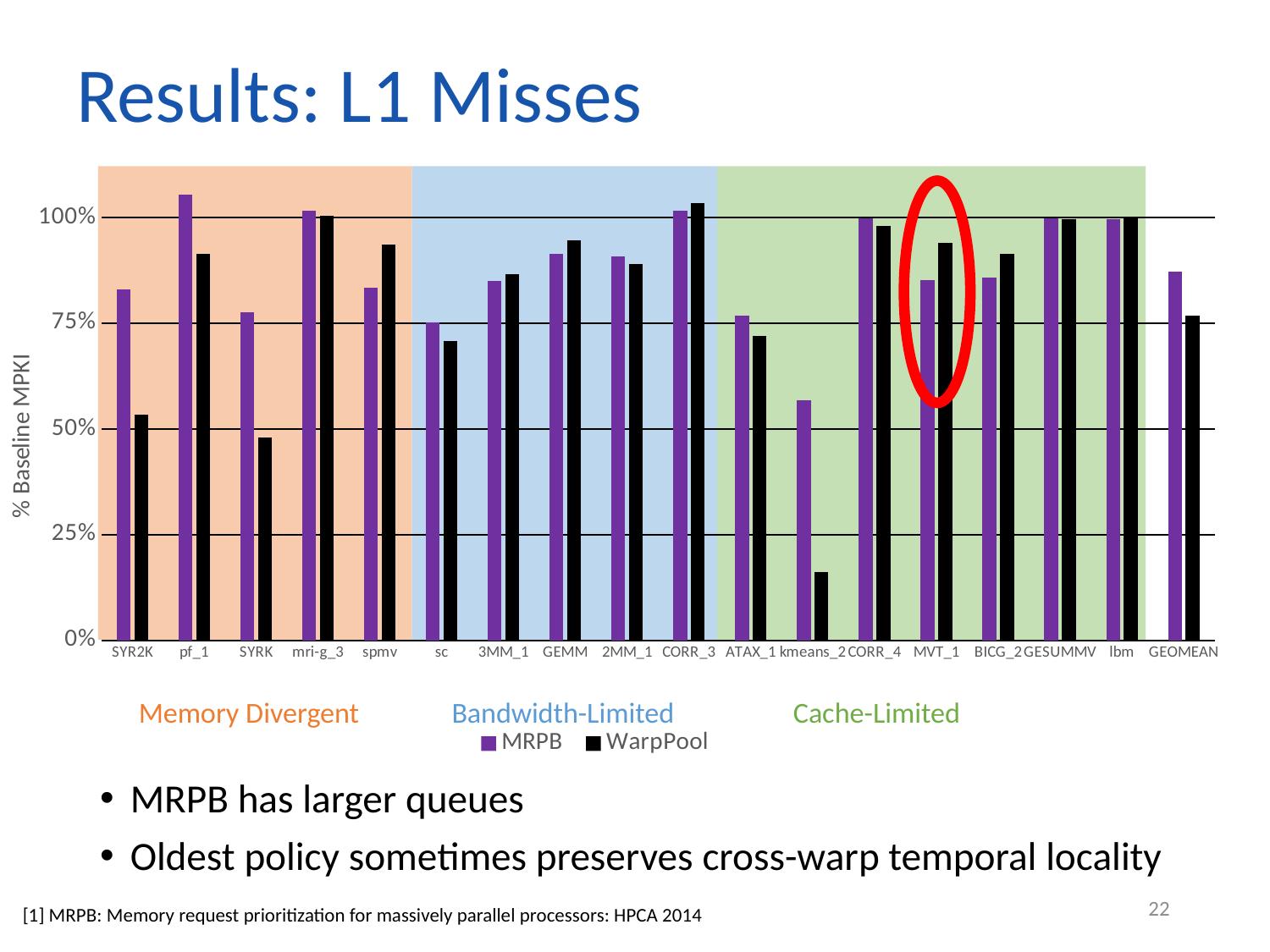
What kind of chart is shown on the slide? bar chart How many categories are plotted along the x axis? 18 How many series does the legend list? 2 Which category has the highest MRPB bar? pf_1 Which category has the lowest WarpPool bar? kmeans_2 For kmeans_2, which is larger, the MRPB value or the WarpPool value? MRPB Which category's bars are circled in red? MVT_1 Is the MRPB value for pf_1 greater or less than 100%? greater Is the WarpPool value for SYRK greater or less than 75%? less Is the WarpPool value for kmeans_2 greater or less than 25%? less What is the label of the y axis? % Baseline MPKI For SYR2K, which is larger, the MRPB value or the WarpPool value? MRPB